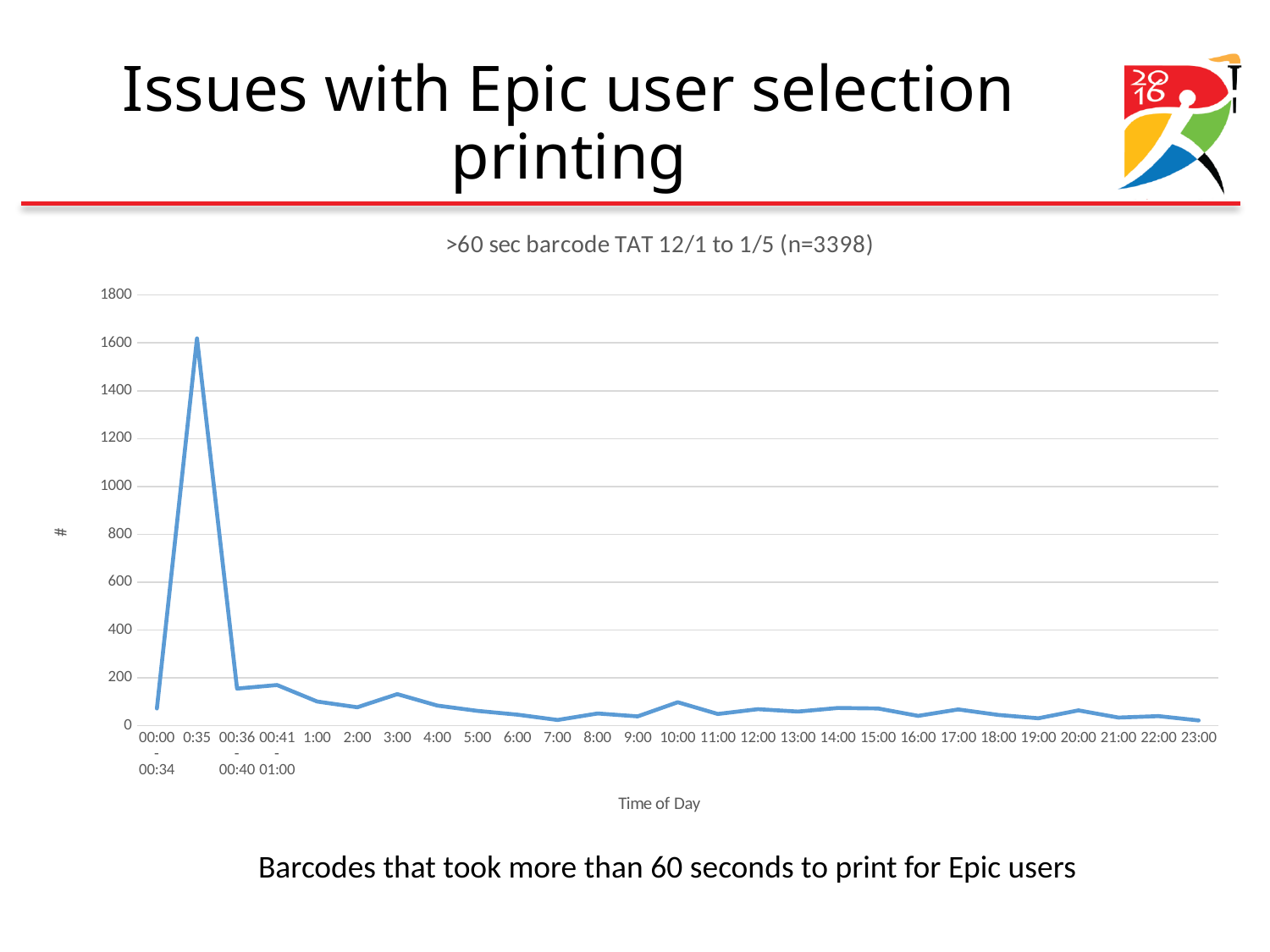
Is the value for 3:00 greater or less than 400? less Does the line rise or fall between 0:35 and 00:36-00:40? fall Is the value for 0:35 greater or less than 1400? greater How many time-of-day points are plotted on the chart? 27 What kind of chart is shown on the slide? line chart Which has a larger value, 0:35 or 3:00? 0:35 Is the value for 00:00-00:34 greater or less than 200? less What is the x-axis title of the chart? Time of Day Which time of day has the highest value on the chart? 0:35 Which has a larger value, 3:00 or 7:00? 3:00 What is the title of the chart? >60 sec barcode TAT 12/1 to 1/5 (n=3398)